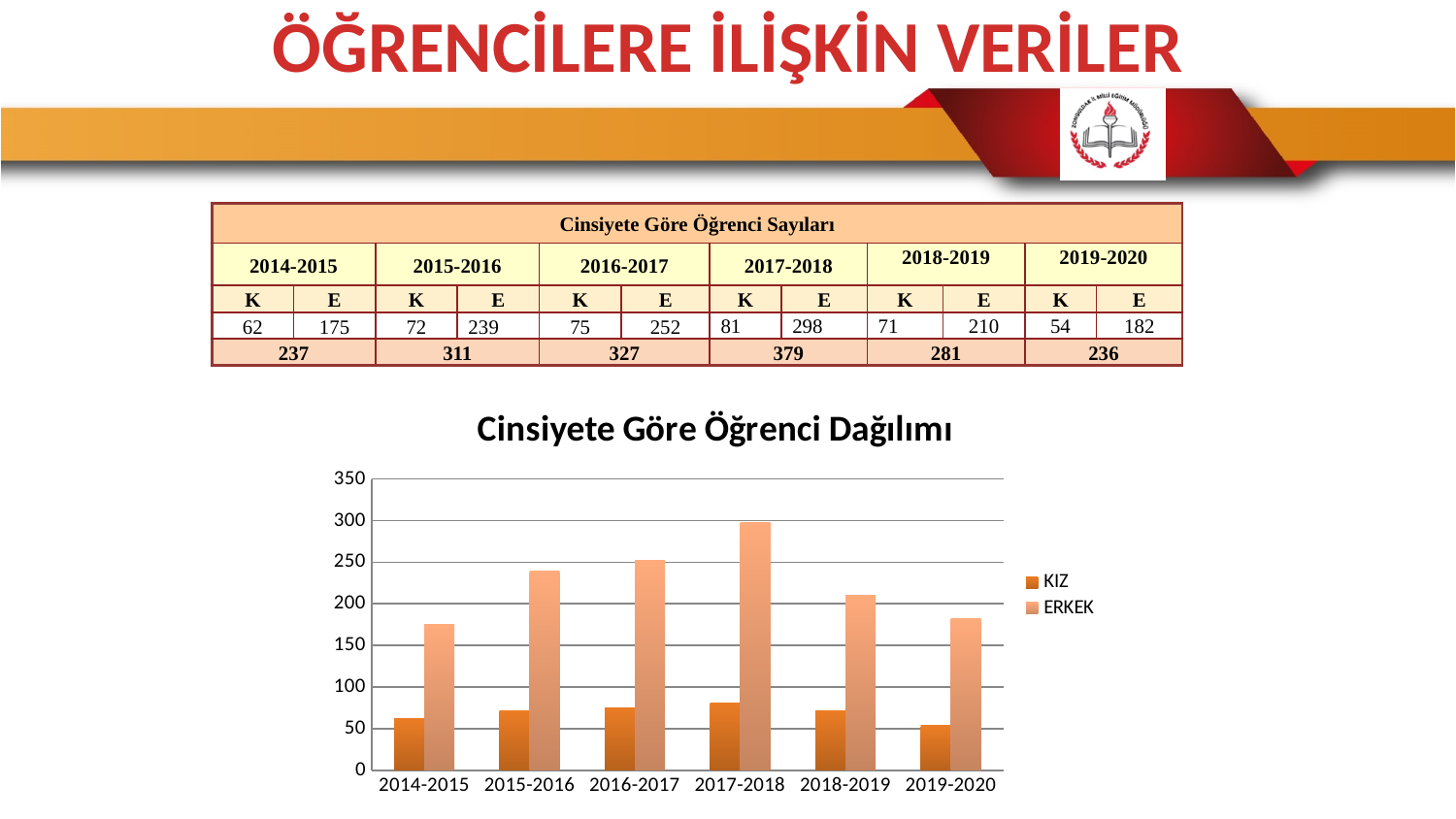
According to the table on the slide, what is the E (ERKEK) value for 2016-2017? 252 Is the ERKEK value for 2017-2018 greater or less than 250? greater Is the KIZ value for 2014-2015 greater or less than 100? less What kind of chart is shown on the slide? bar chart Which academic year has the highest ERKEK value in the chart? 2017-2018 Which academic year has the lowest KIZ value in the chart? 2019-2020 Which is larger in the chart: the ERKEK value for 2015-2016 or the ERKEK value for 2018-2019? 2015-2016 Is the ERKEK value for 2019-2020 greater or less than 200? less How many academic years are shown on the x axis of the chart? 6 What is the title of the chart? Cinsiyete Göre Öğrenci Dağılımı According to the table on the slide, what is the total number of students for 2017-2018? 379 How many series does the chart legend list? 2